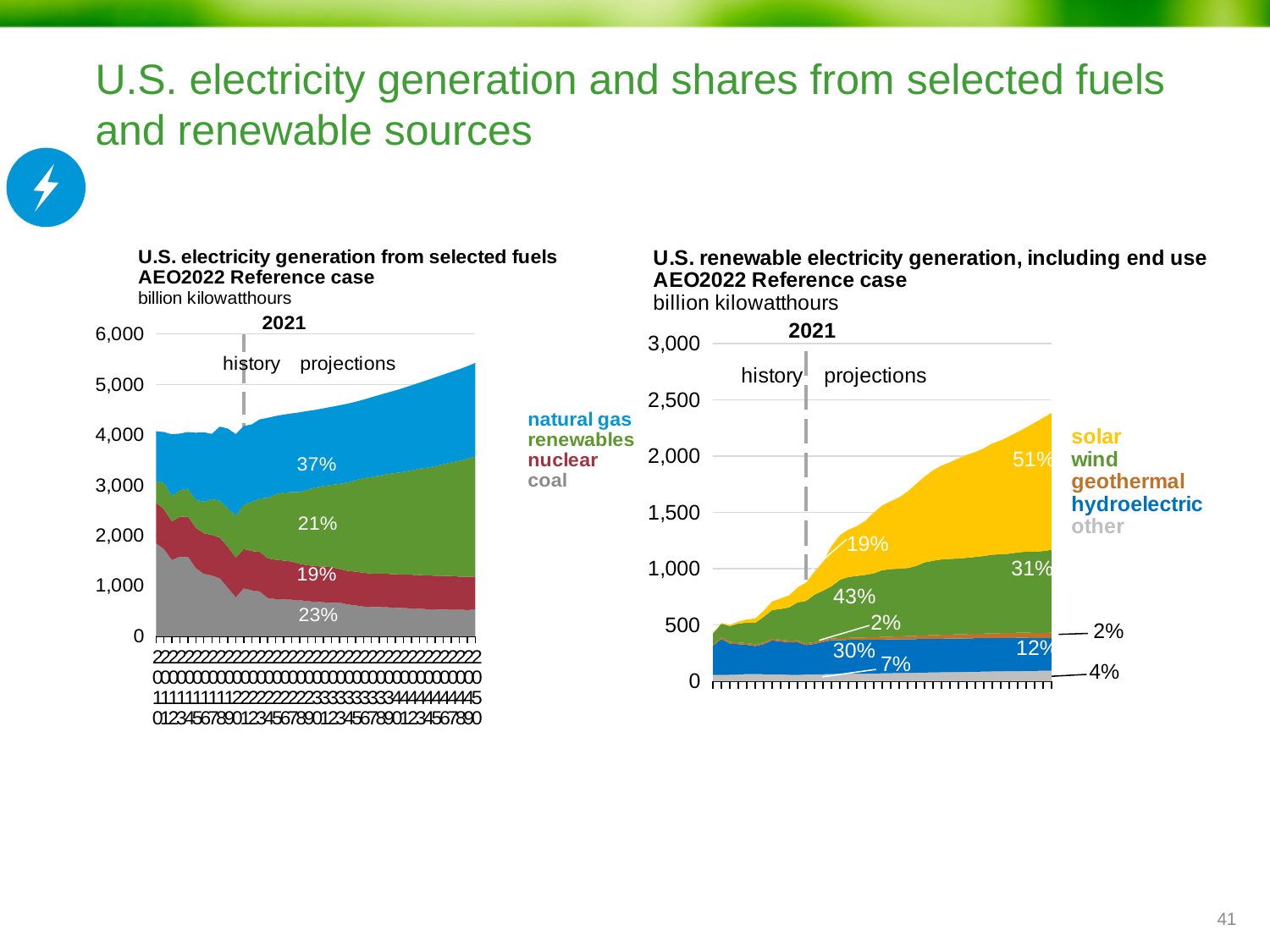
On the right chart (U.S. renewable electricity generation), does total renewable generation rise or fall across the projection period? rise On the left chart (U.S. electricity generation from selected fuels), what year does the dashed line separating history and projections mark? 2021 On the right chart (U.S. renewable electricity generation), is total renewable generation at the right end of the projections greater or less than 2,000 billion kilowatthours? greater On the left chart (U.S. electricity generation from selected fuels), how many series does the legend list? 4 On the left chart (U.S. electricity generation from selected fuels), what kind of chart is it? Stacked area chart On the left chart (U.S. electricity generation from selected fuels), which fuel has the largest share label? natural gas On the right chart (U.S. renewable electricity generation), how many series does the legend list? 5 On the left chart (U.S. electricity generation from selected fuels), what share label is shown for natural gas? 37% On the right chart (U.S. renewable electricity generation), what share label is shown for wind at the right end of the projections? 31% On the right chart (U.S. renewable electricity generation), what share label is shown for solar at the right end of the projections? 51% On the left chart (U.S. electricity generation from selected fuels), what share label is shown for nuclear? 19% On the left chart (U.S. electricity generation from selected fuels), is the total generation at the right end of the projections greater or less than 5,000 billion kilowatthours? greater